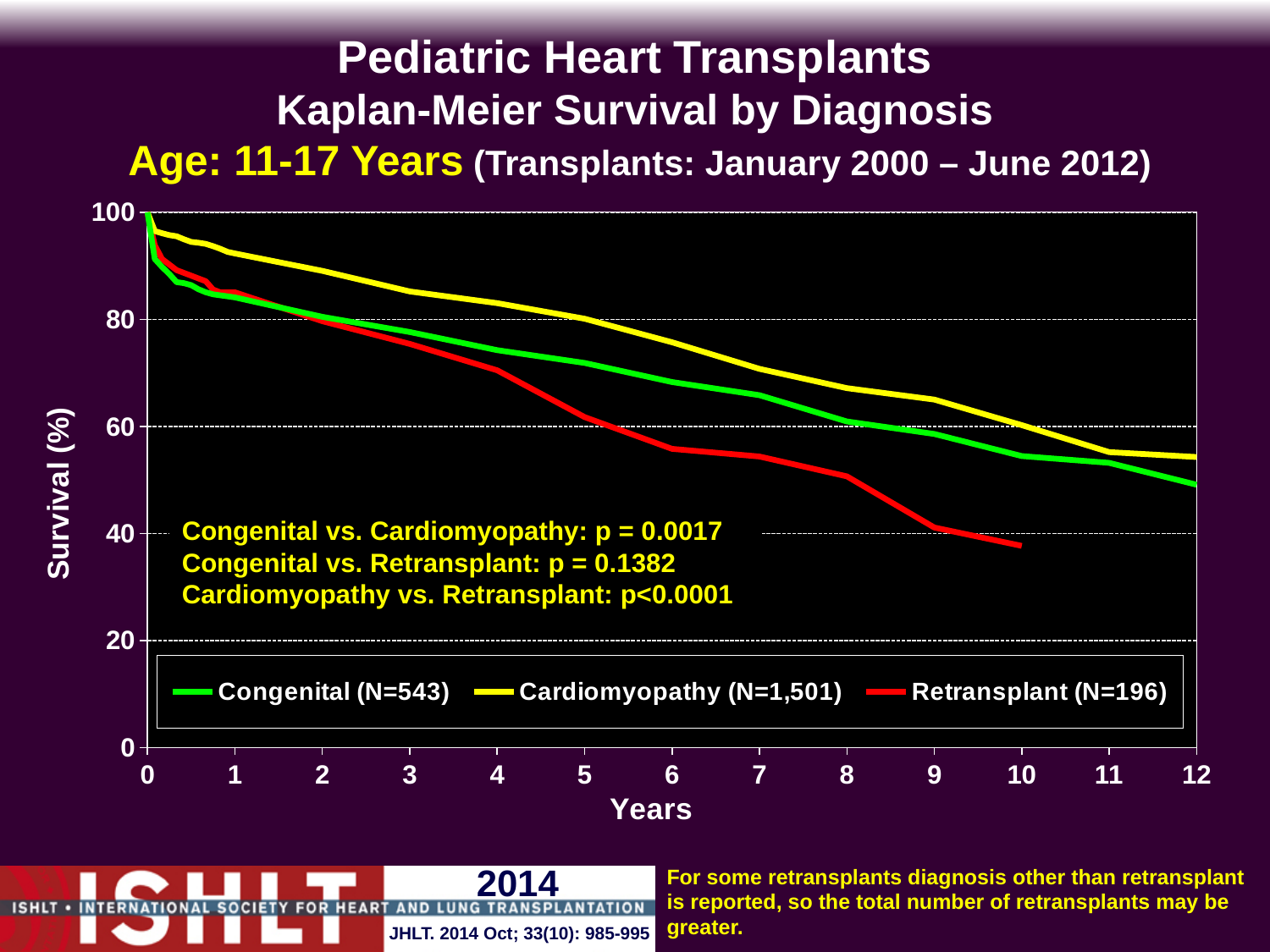
Which diagnosis group has the lowest survival at 10 years? Retransplant What kind of chart is shown on the slide? Line chart At 6 years, which group has higher survival, Cardiomyopathy or Retransplant? Cardiomyopathy Is the survival for Congenital at 12 years greater or less than 60? less Do the survival curves rise or fall as years since transplant increase? Fall At 9 years, which group has higher survival, Congenital or Retransplant? Congenital What is the N for the Cardiomyopathy group shown in the legend? N=1,501 Which diagnosis group has the highest survival at 10 years? Cardiomyopathy Is the survival for Cardiomyopathy at 8 years greater or less than 60? greater What p-value is given for Congenital vs. Cardiomyopathy? p = 0.0017 How many series does the legend list? 3 Is the survival for Retransplant at 10 years greater or less than 40? less